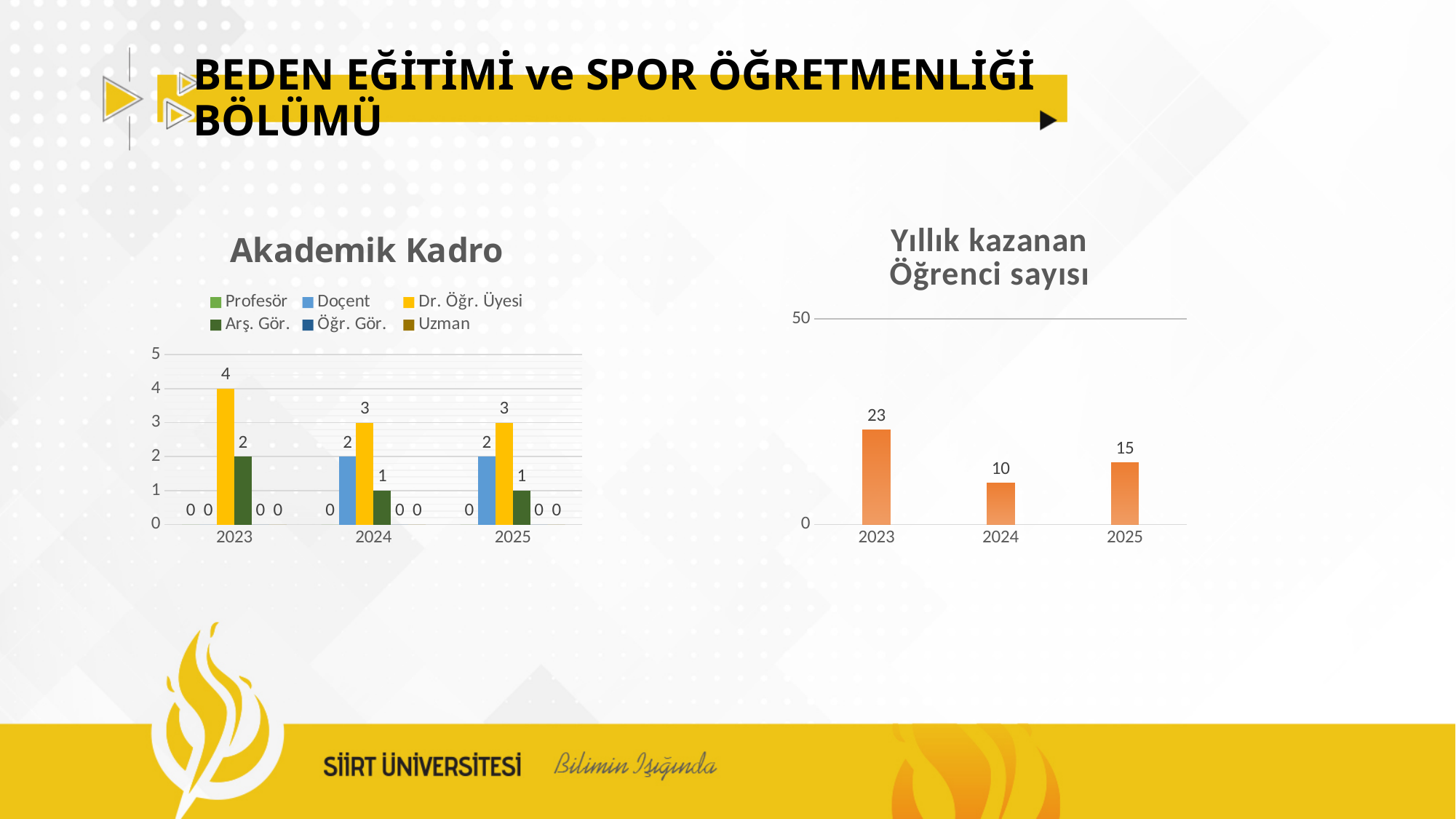
In the 'Akademik Kadro' chart, what is the value for Arş. Gör. in 2025? 1 In the 'Yıllık kazanan Öğrenci sayısı' chart, what is the difference between the values for 2023 and 2025? 8 In the 'Yıllık kazanan Öğrenci sayısı' chart, what is the value for 2023? 23 In the 'Akademik Kadro' chart, what is the value for Doçent in 2024? 2 In the 'Akademik Kadro' chart, what is the value for Dr. Öğr. Üyesi in 2023? 4 What kind of chart is the 'Yıllık kazanan Öğrenci sayısı' chart? Bar chart In the 'Yıllık kazanan Öğrenci sayısı' chart, which year has the lowest value? 2024 In the 'Yıllık kazanan Öğrenci sayısı' chart, how many years are shown on the x axis? 3 In the 'Akademik Kadro' chart, what is the difference between the Dr. Öğr. Üyesi value in 2023 and in 2024? 1 In the 'Akademik Kadro' chart, how many series does the legend list? 6 In the 'Akademik Kadro' chart, which year has the highest value for Dr. Öğr. Üyesi? 2023 In the 'Yıllık kazanan Öğrenci sayısı' chart, which is larger, the value for 2024 or 2025? 2025